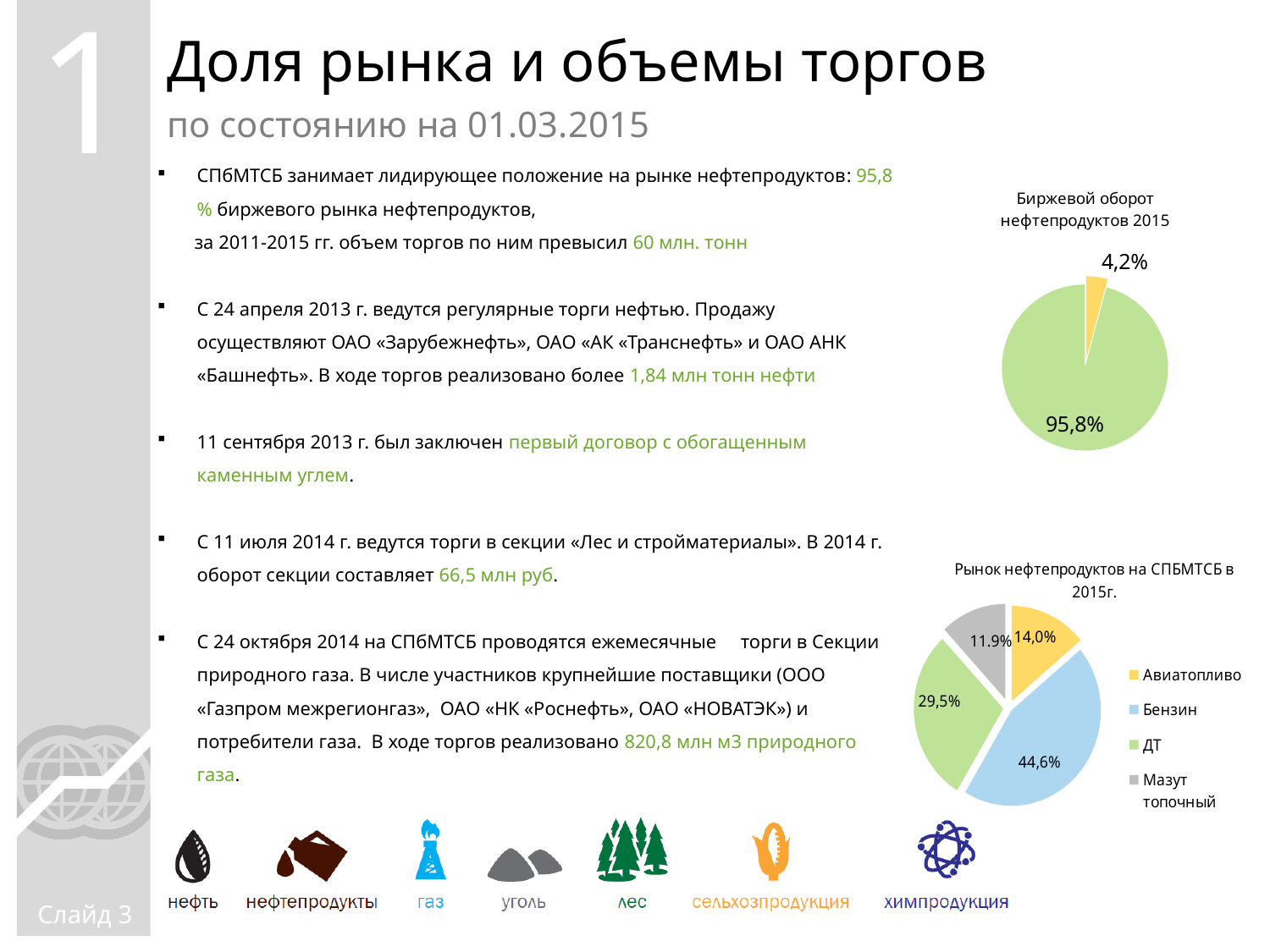
In the chart "Рынок нефтепродуктов на СПБМТСБ в 2015г.", what colour represents Бензин? light blue In the chart "Рынок нефтепродуктов на СПБМТСБ в 2015г.", which category has the largest share? Бензин In the chart "Биржевой оборот нефтепродуктов 2015", what is the value of the larger slice? 95,8% In the chart "Рынок нефтепродуктов на СПБМТСБ в 2015г.", what share does ДТ have? 29,5% In the chart "Рынок нефтепродуктов на СПБМТСБ в 2015г.", which is larger: the share of ДТ or the share of Авиатопливо? ДТ In the chart "Рынок нефтепродуктов на СПБМТСБ в 2015г.", what share does Мазут топочный have? 11.9% In the chart "Рынок нефтепродуктов на СПБМТСБ в 2015г.", how many categories does the legend list? 4 In the chart "Рынок нефтепродуктов на СПБМТСБ в 2015г.", what share does Авиатопливо have? 14,0% In the chart "Рынок нефтепродуктов на СПБМТСБ в 2015г.", which category has the smallest share? Мазут топочный What type of chart is the chart titled "Рынок нефтепродуктов на СПБМТСБ в 2015г."? pie chart In the chart "Рынок нефтепродуктов на СПБМТСБ в 2015г.", what share does Бензин have? 44,6% In the chart "Биржевой оборот нефтепродуктов 2015", what is the value of the smaller slice? 4,2%